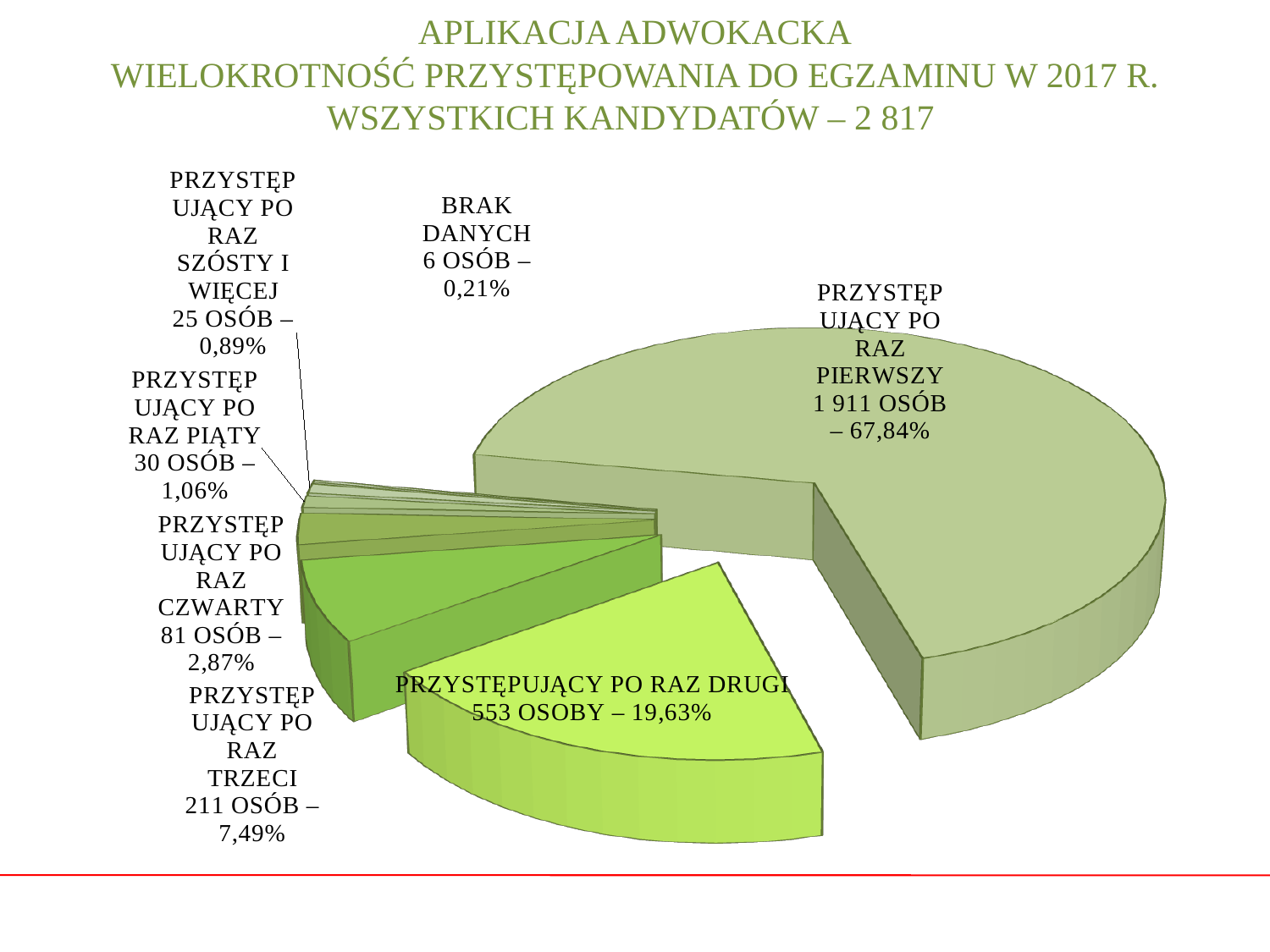
Which slice of the pie chart is the largest? PRZYSTĘPUJĄCY PO RAZ PIERWSZY What percentage share does the PRZYSTĘPUJĄCY PO RAZ DRUGI slice have? 19,63% What is the difference in number of people between PRZYSTĘPUJĄCY PO RAZ PIERWSZY and PRZYSTĘPUJĄCY PO RAZ DRUGI? 1 358 Which slice of the pie chart is the smallest? BRAK DANYCH How many people are in the PRZYSTĘPUJĄCY PO RAZ TRZECI slice? 211 OSÓB What percentage share does the PRZYSTĘPUJĄCY PO RAZ CZWARTY slice have? 2,87% How many slices does the pie chart have? 7 According to the chart title, what is the total number of candidates? 2 817 Which slice has more people, PRZYSTĘPUJĄCY PO RAZ PIĄTY or PRZYSTĘPUJĄCY PO RAZ SZÓSTY I WIĘCEJ? PRZYSTĘPUJĄCY PO RAZ PIĄTY How many people are in the BRAK DANYCH slice? 6 OSÓB What kind of chart is shown on the slide? pie chart How many people are in the PRZYSTĘPUJĄCY PO RAZ PIERWSZY slice? 1 911 OSÓB